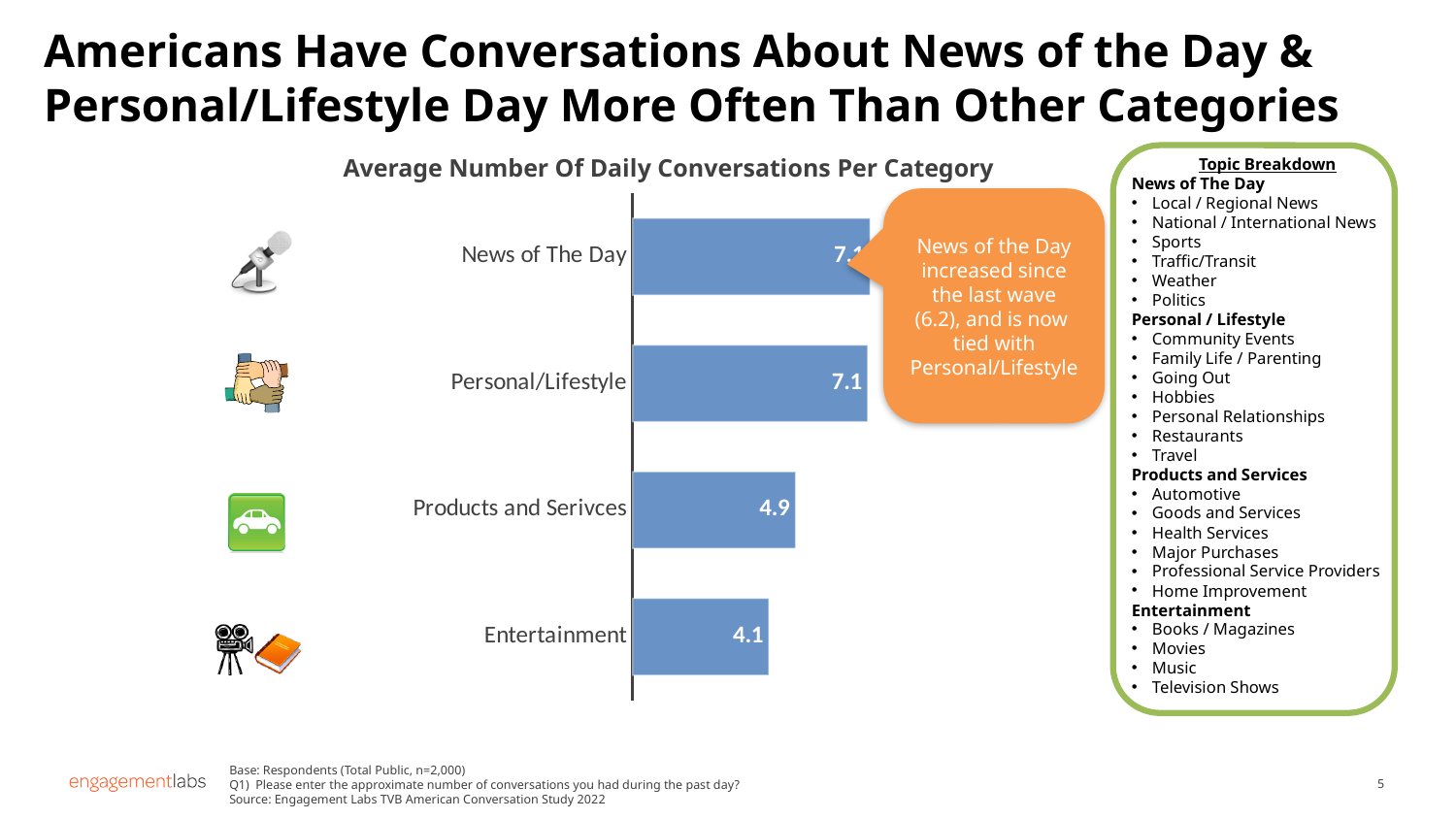
What is the difference between the values for Products and Services and Entertainment? 0.8 What kind of chart is shown on the slide? Bar chart What is the title of the chart? Average Number Of Daily Conversations Per Category According to the callout, what was the News of the Day value in the last wave? 6.2 What is the average number of daily conversations for News of The Day? 7.1 Which category has the lowest average number of daily conversations? Entertainment How many categories are shown in the chart? 4 What is the average number of daily conversations for Personal/Lifestyle? 7.1 What is the average number of daily conversations for Entertainment? 4.1 What is the difference between the values for Personal/Lifestyle and Products and Services? 2.2 What is the average number of daily conversations for Products and Services? 4.9 Which is larger, the value for Products and Services or the value for Entertainment? Products and Services